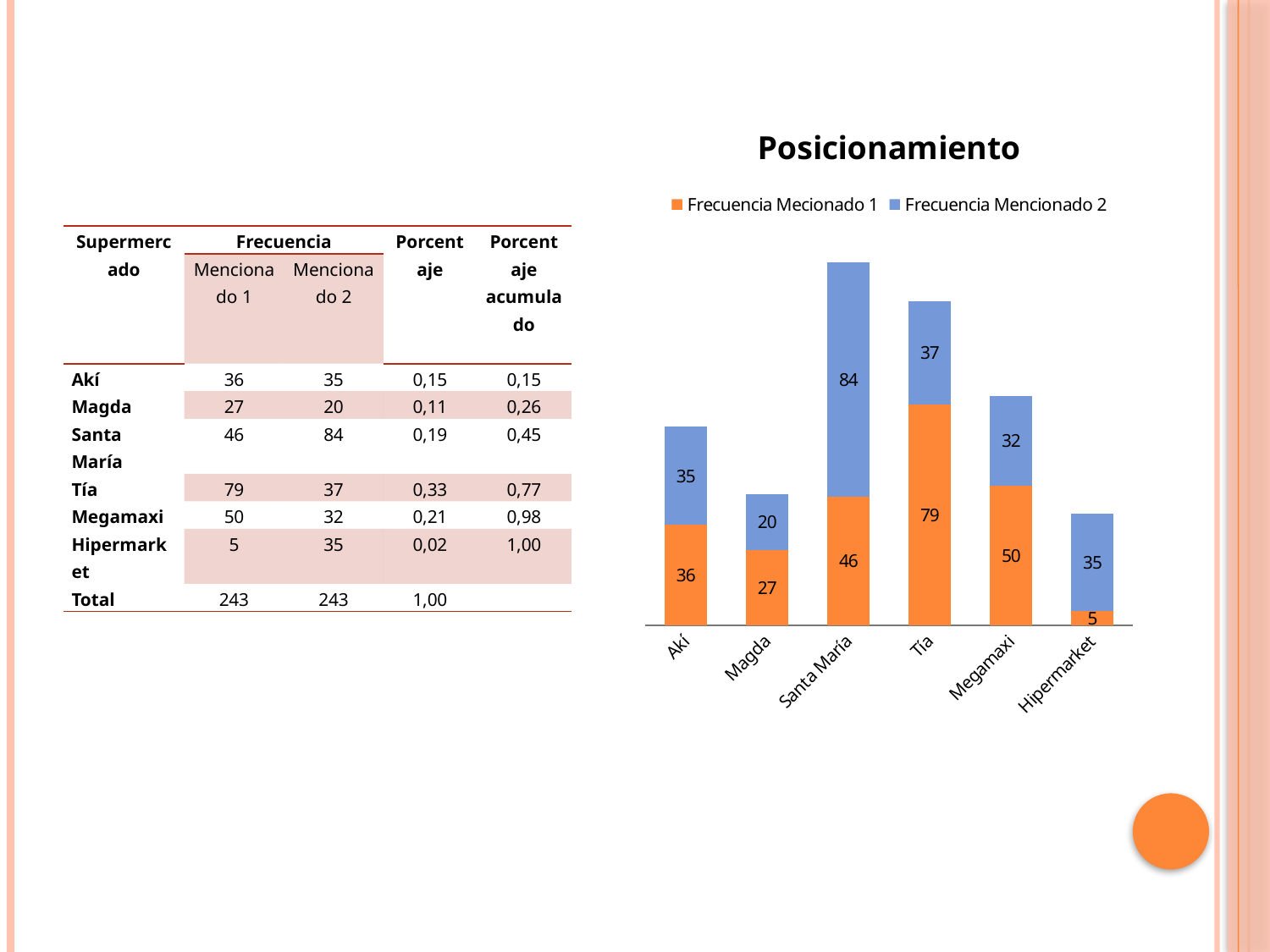
What kind of chart is shown on the slide? Stacked bar chart How many supermarkets are shown on the x axis of the chart? 6 Which has the larger Frecuencia Mencionado 2 value, Akí or Magda? Akí What is the title of the chart? Posicionamiento Which supermarket has the highest Frecuencia Mencionado 2 value? Santa María Which supermarket has the highest Frecuencia Mecionado 1 value? Tía What is the total of the stacked bar for Santa María? 130 What is the value of Frecuencia Mencionado 2 for Santa María? 84 How many series does the chart legend list? 2 Which supermarket has the lowest Frecuencia Mecionado 1 value? Hipermarket What is the difference between the Frecuencia Mecionado 1 values for Tía and Megamaxi? 29 What is the value of Frecuencia Mecionado 1 for Tía? 79